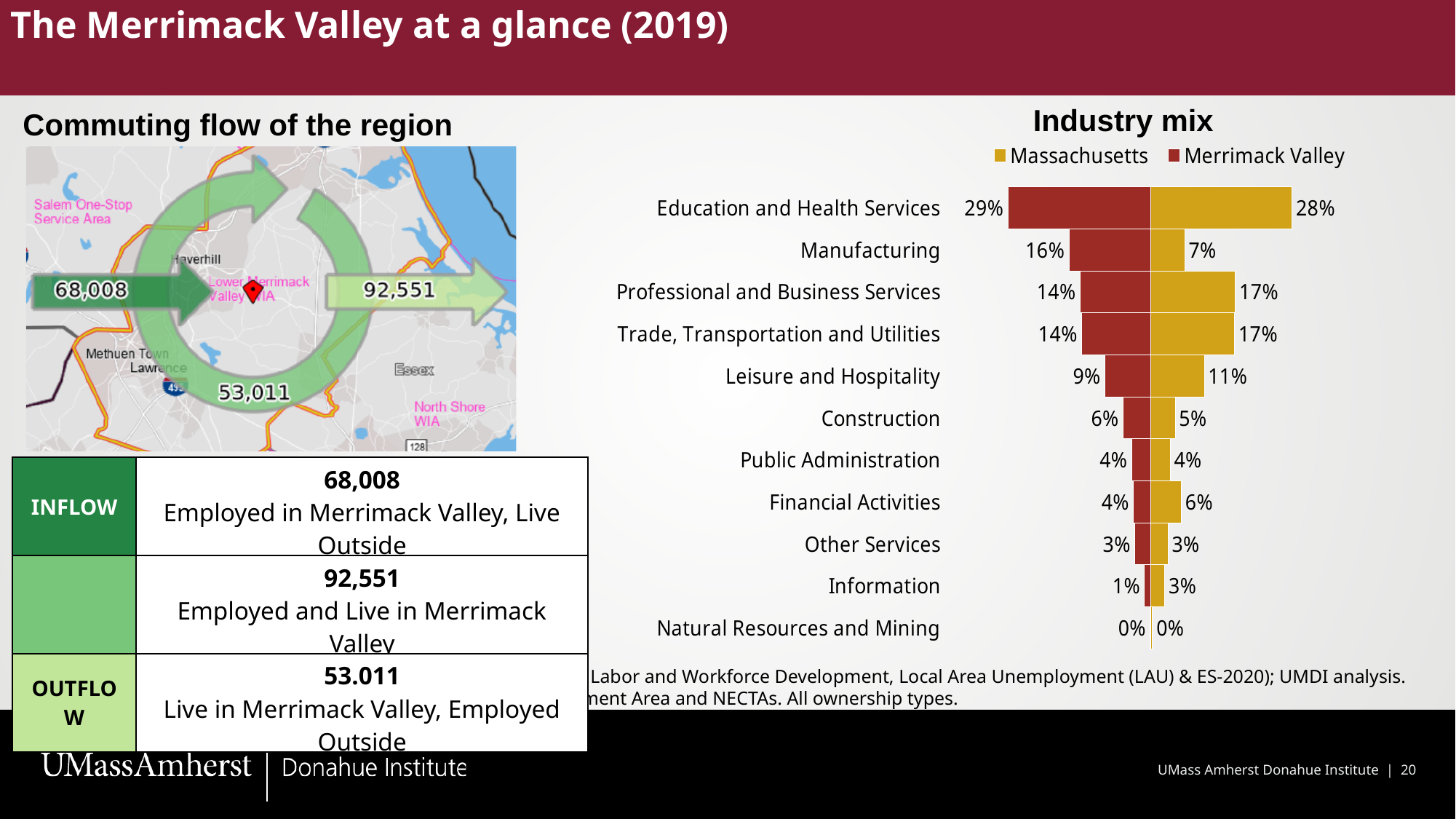
In the Industry mix chart, what is the Massachusetts value for Education and Health Services? 28% In the Industry mix chart, what is the difference between the Merrimack Valley and Massachusetts values for Manufacturing? 9% How many series does the legend of the Industry mix chart list? 2 In the Industry mix chart, is the Financial Activities share larger for Massachusetts or Merrimack Valley? Massachusetts In the Industry mix chart, which industry has the lowest Massachusetts share? Natural Resources and Mining How many industries are listed in the Industry mix chart? 11 What kind of chart is the Industry mix chart? Bar chart In the Industry mix chart, what is the Merrimack Valley value for Manufacturing? 16% In the Industry mix chart, is the Construction share larger for Massachusetts or Merrimack Valley? Merrimack Valley In the Industry mix chart, what is the Massachusetts value for Leisure and Hospitality? 11% In the Industry mix chart, what is the difference between the Massachusetts and Merrimack Valley values for Professional and Business Services? 3% In the Industry mix chart, which industry has the highest Merrimack Valley share? Education and Health Services